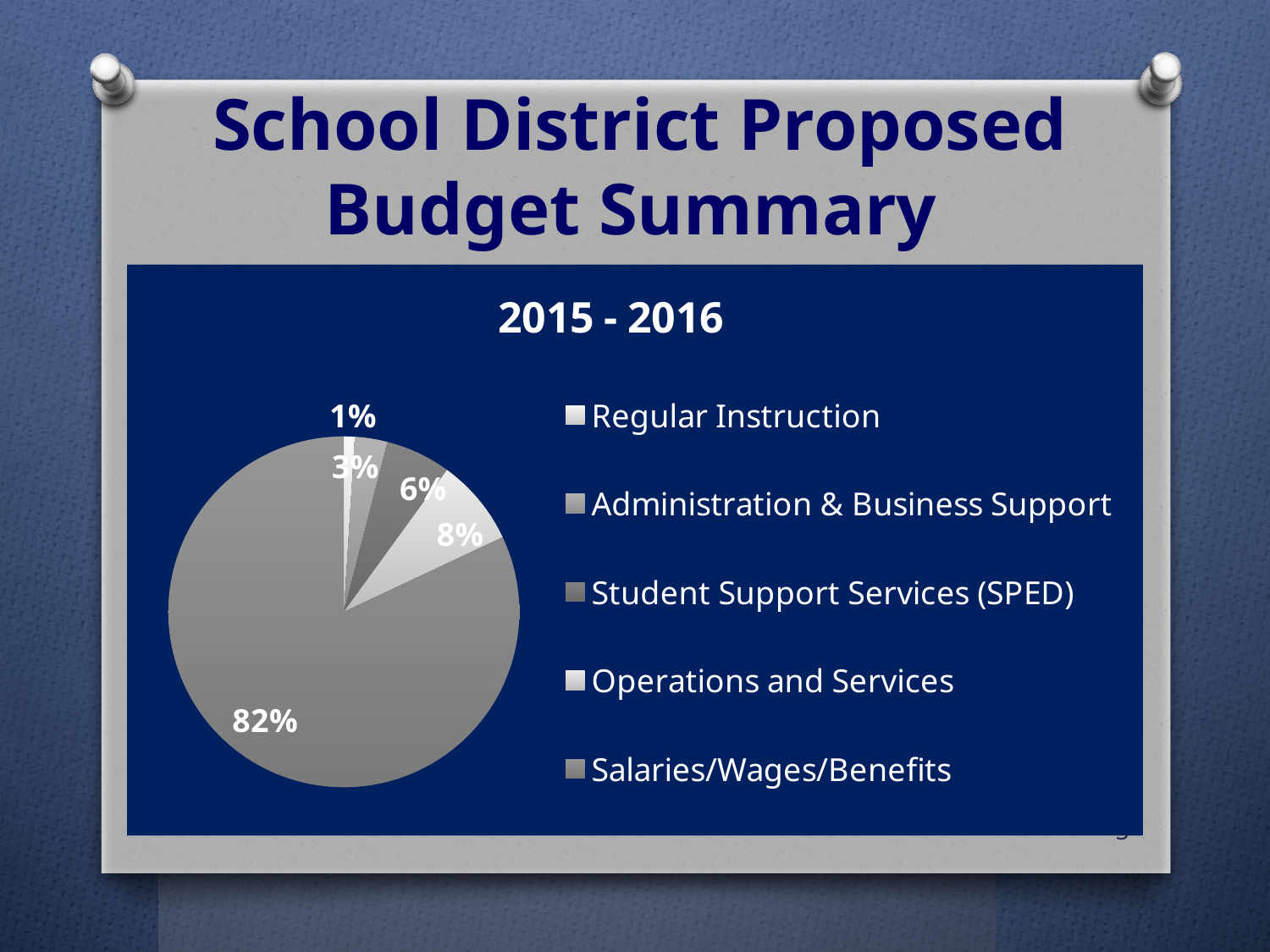
What is the largest percentage shown on the pie chart? 82% What share of the budget does Salaries/Wages/Benefits represent? 82% Which legend entry is listed first in the pie chart's legend? Regular Instruction What kind of chart is shown on the slide? pie chart Which is larger, the 6% slice or the 8% slice? the 8% slice Which category accounts for 82% of the budget in the pie chart? Salaries/Wages/Benefits How many slices does the pie chart have? 5 What is the difference between the largest slice (82%) and the second-largest slice (8%)? 74% What is the combined share of the four smallest slices (1%, 3%, 6%, 8%)? 18% How many entries does the legend of the pie chart list? 5 What is the title shown above the pie chart? 2015 - 2016 What is the smallest percentage shown on the pie chart? 1%